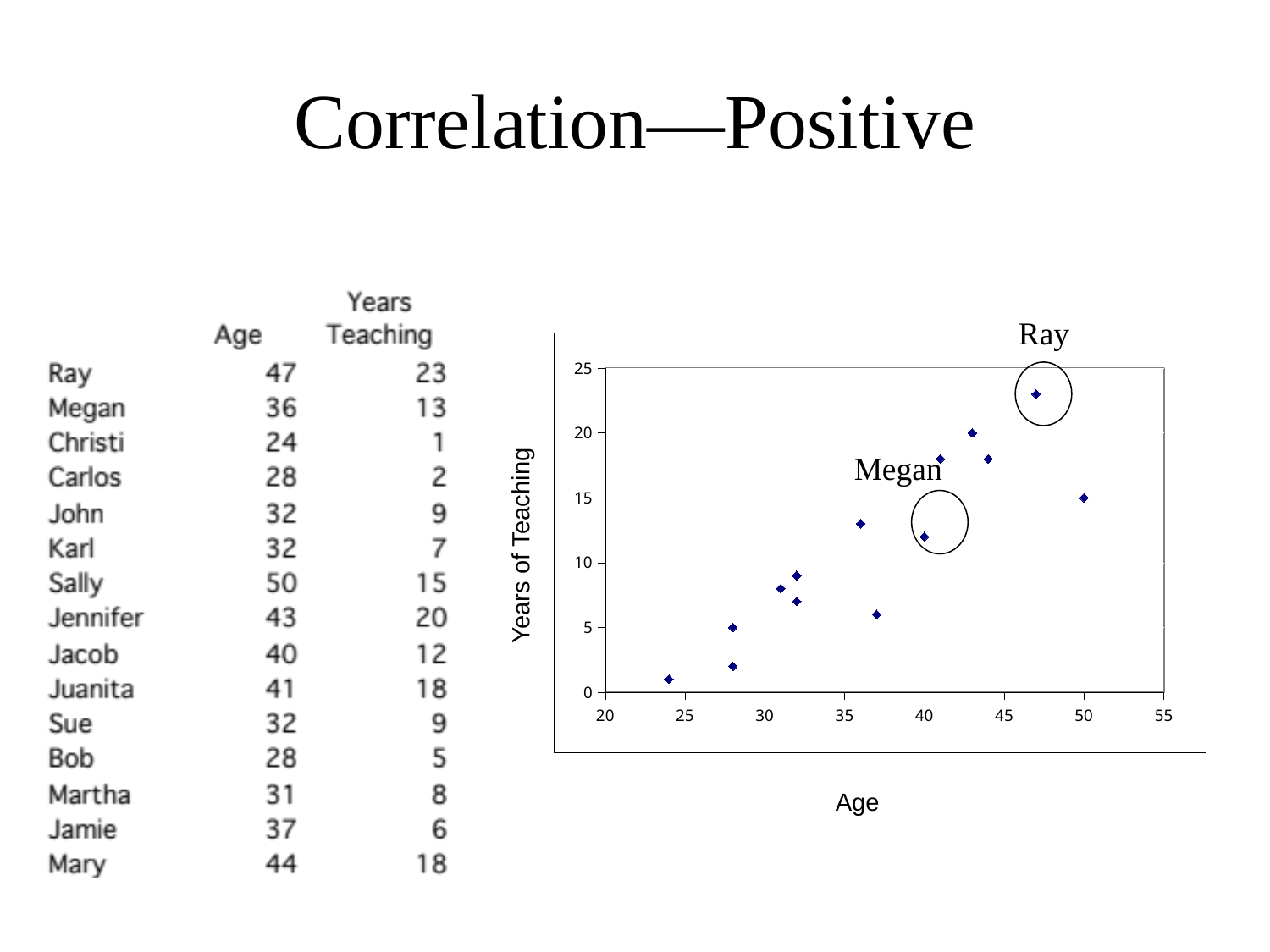
Is the Years of Teaching value for the point at age 37 greater or less than 10? less Is the Years of Teaching value for the point labeled Megan greater or less than 15? less Do the values of Years of Teaching generally rise or fall as Age increases along the x axis? rise What is the title of the slide containing the chart? Correlation—Positive What kind of chart is shown on the slide? scatter chart Which labeled point on the chart has the highest Years of Teaching value? Ray Is the Years of Teaching value for the point at age 24 greater or less than 5? less What is the label on the vertical axis of the chart? Years of Teaching What is the highest value shown on the vertical axis of the chart? 25 Which has the larger Years of Teaching value, the point labeled Ray or the point labeled Megan? Ray